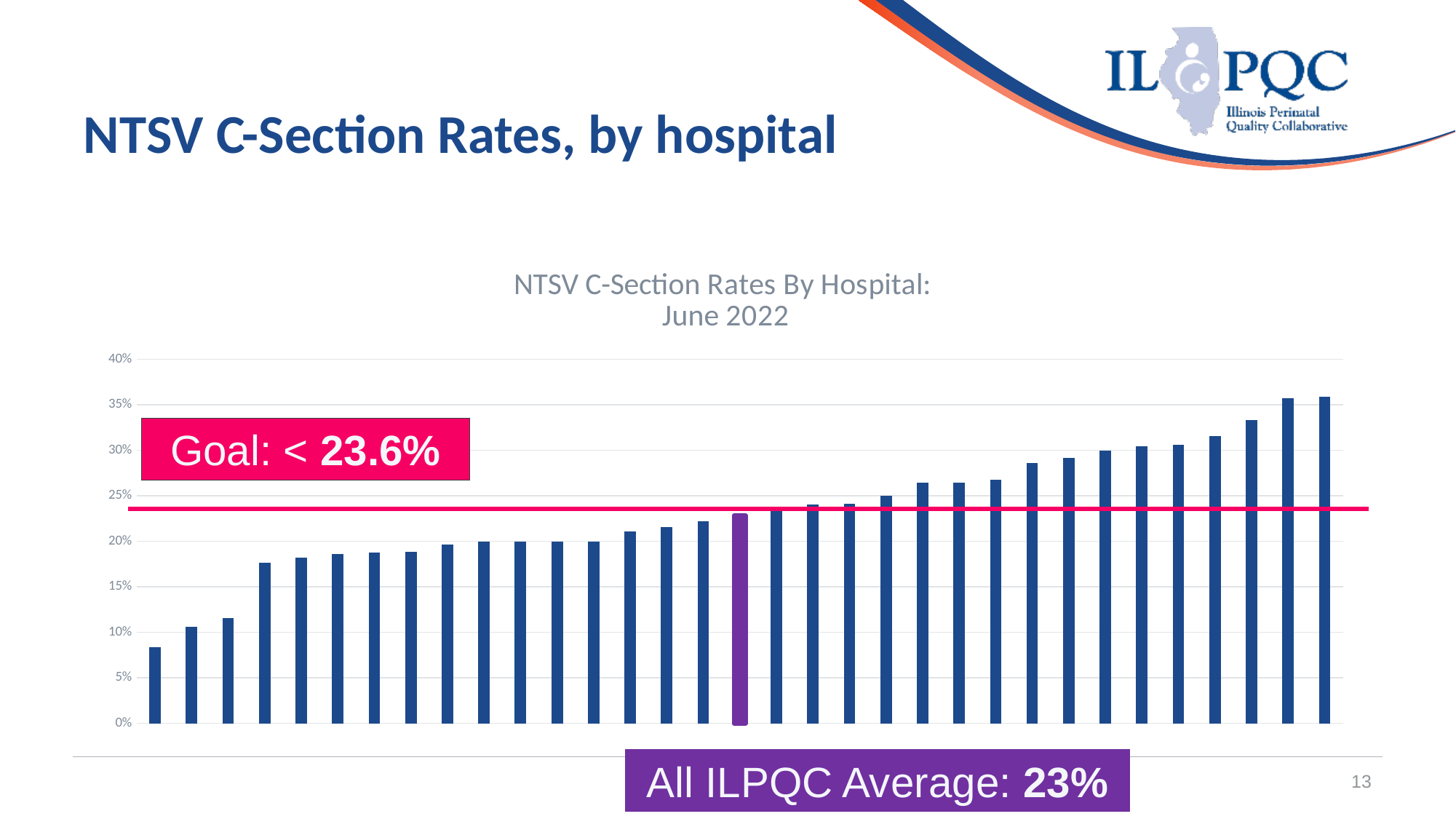
Is the value of the rightmost bar greater or less than 35%? greater What colour is the bar representing the All ILPQC Average? purple Is the horizontal goal line drawn above or below the 25% gridline? below Is the All ILPQC Average (23%) greater or less than the goal of 23.6%? less Is the value of the leftmost bar greater or less than 10%? less What is the title of the chart? NTSV C-Section Rates By Hospital: June 2022 Which bar is larger, the leftmost bar or the rightmost bar? the rightmost bar Do the bar values rise or fall from left to right across the chart? rise What goal is shown on the chart for the NTSV C-section rate? < 23.6% What is the All ILPQC Average NTSV C-section rate shown on the chart? 23% What kind of chart is shown on the slide? bar chart